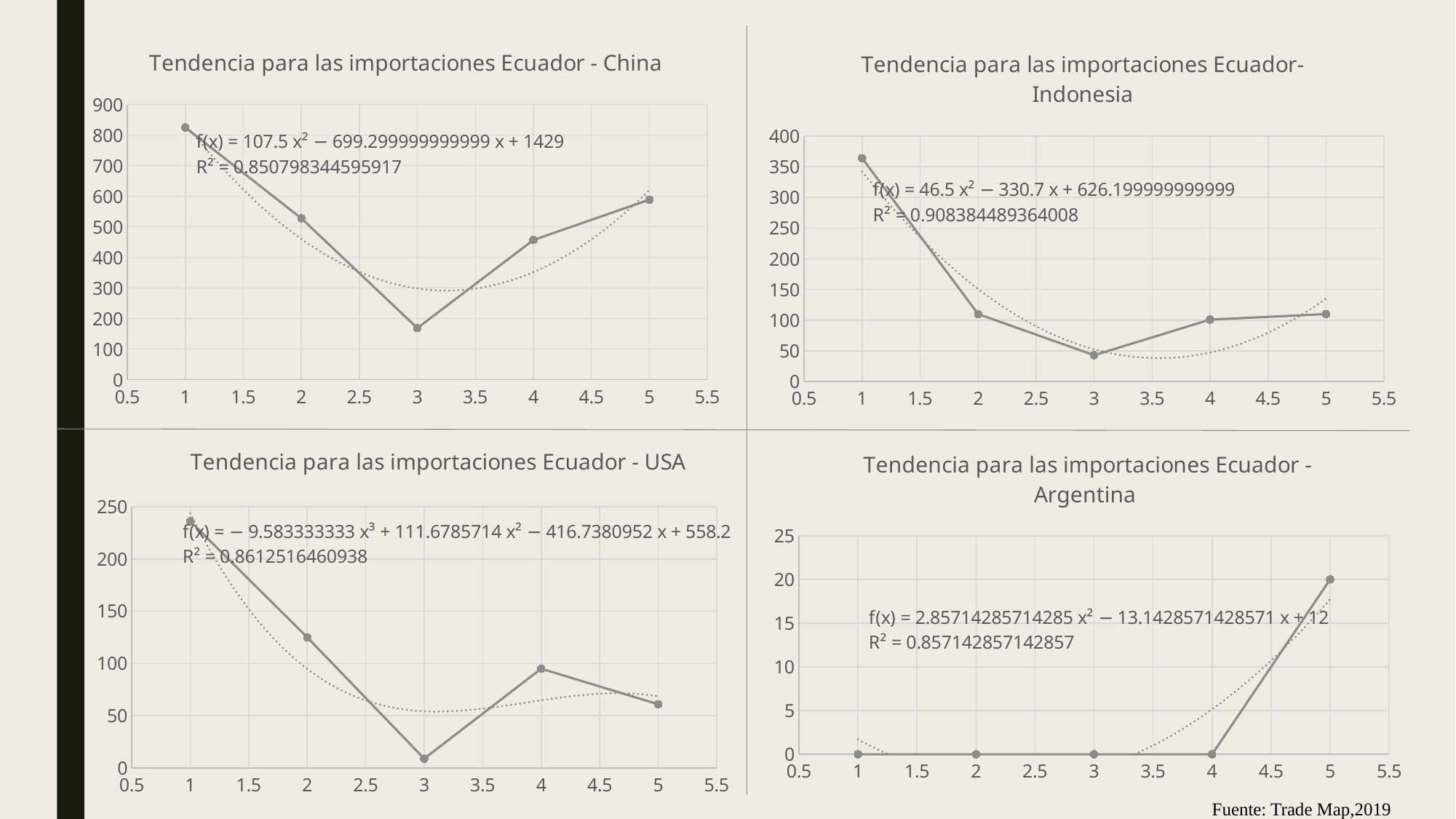
In the chart 'Tendencia para las importaciones Ecuador - Argentina', what is the plotted value at x = 2? 0 In the chart 'Tendencia para las importaciones Ecuador - China', is the value at x = 1 greater or less than 800? greater In the chart 'Tendencia para las importaciones Ecuador - China', at which x value is the plotted value highest? 1 In the chart 'Tendencia para las importaciones Ecuador- Indonesia', at which x value is the plotted value lowest? 3 In the chart 'Tendencia para las importaciones Ecuador - China', what R² value is shown for the trendline? 0.850798344595917 In the chart 'Tendencia para las importaciones Ecuador - Argentina', what is the plotted value at x = 5? 20 In the chart 'Tendencia para las importaciones Ecuador - China', at which x value is the plotted value lowest? 3 In the chart 'Tendencia para las importaciones Ecuador- Indonesia', is the value at x = 1 greater or less than 350? greater In the chart 'Tendencia para las importaciones Ecuador - USA', which is larger, the value at x = 2 or the value at x = 4? x = 2 In the chart 'Tendencia para las importaciones Ecuador - China', is the value at x = 3 greater or less than 200? less How many data points are plotted in the chart 'Tendencia para las importaciones Ecuador - USA'? 5